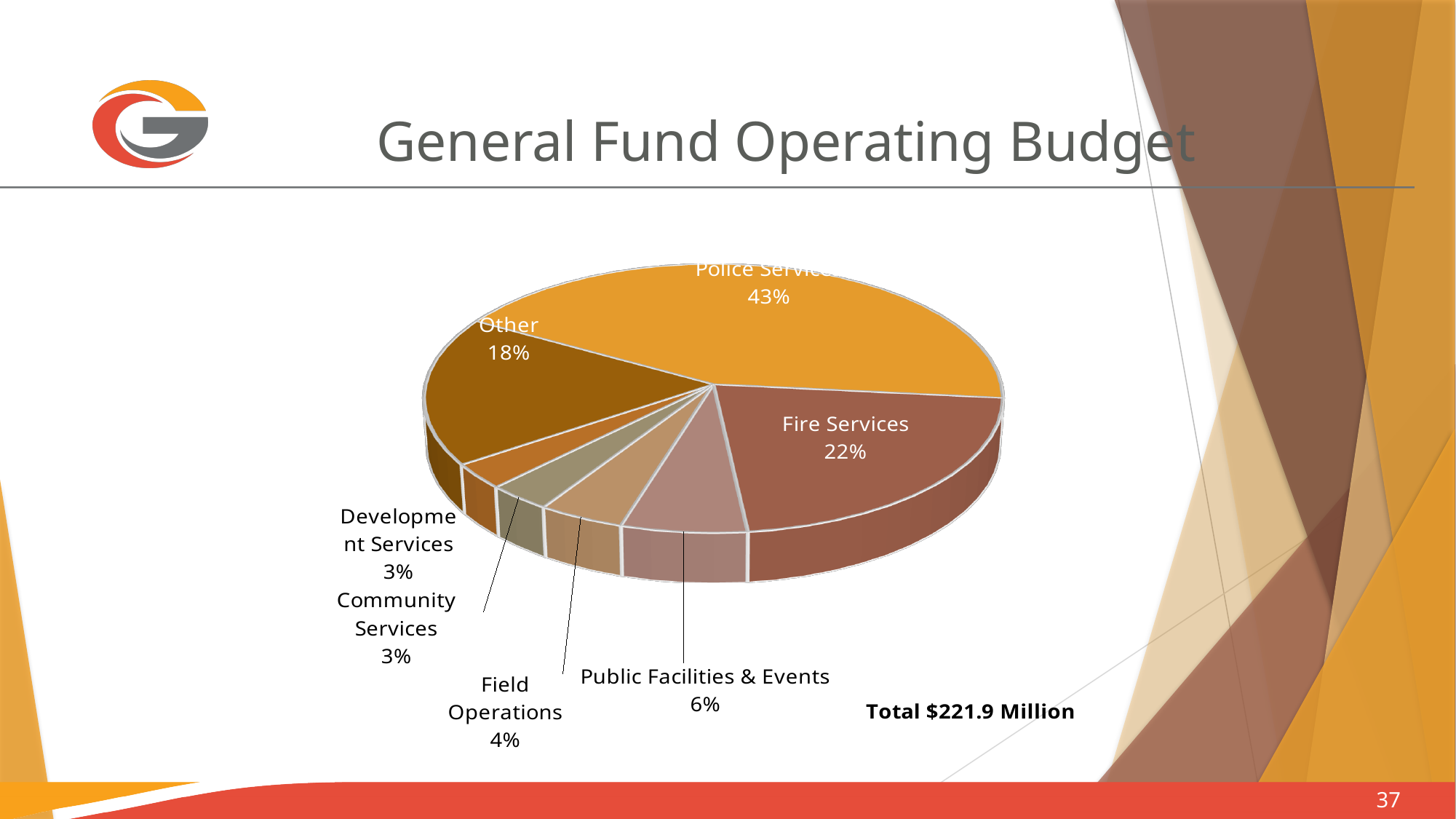
What kind of chart is shown on the slide? Pie chart What is the title of the slide containing the pie chart? General Fund Operating Budget What percentage is shown for Public Facilities & Events? 6% What share does the Other slice represent? 18% What is the total budget amount stated on the slide? $221.9 Million What share of the General Fund Operating Budget goes to Police Services? 43% Which category has the largest slice of the pie? Police Services Which is larger, the Other slice or the Fire Services slice? Fire Services What percentage is shown for Field Operations? 4% What is the difference in percentage points between Police Services and Fire Services? 21 percentage points What percentage of the pie is Fire Services? 22% How many slices does the pie chart have? 7